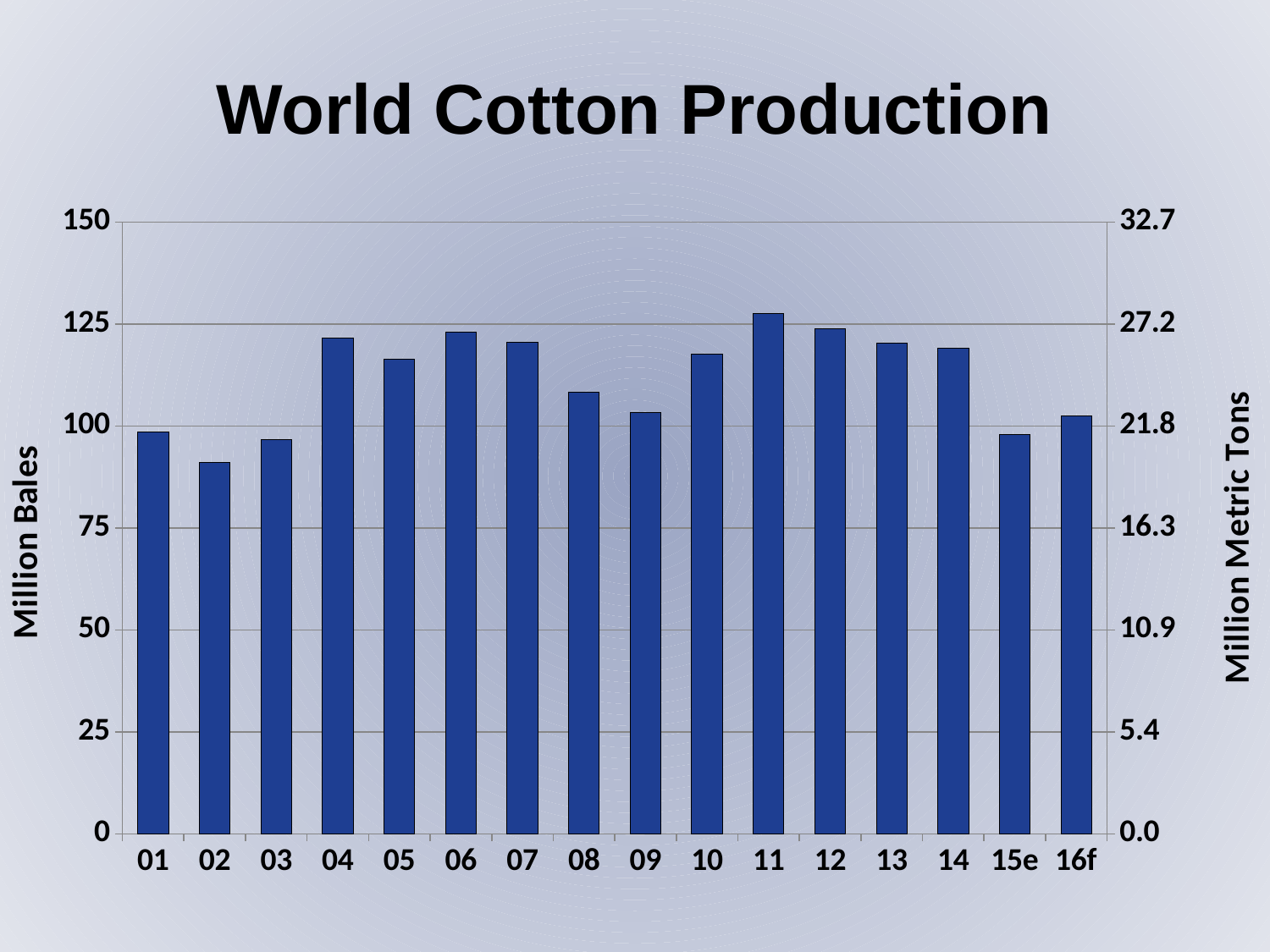
Is the value for 15e greater or less than 100 million bales? less Which year has the larger production, 04 or 02? 04 What kind of chart is shown on the slide? Bar chart Which year has the lowest world cotton production? 02 Is the value for 02 greater or less than 100 million bales? less How many bars (years) are plotted in the chart? 16 What is the label of the left vertical axis? Million Bales Is the value for 04 greater or less than 100 million bales? greater Which year has the highest world cotton production? 11 What is the title of the chart? World Cotton Production